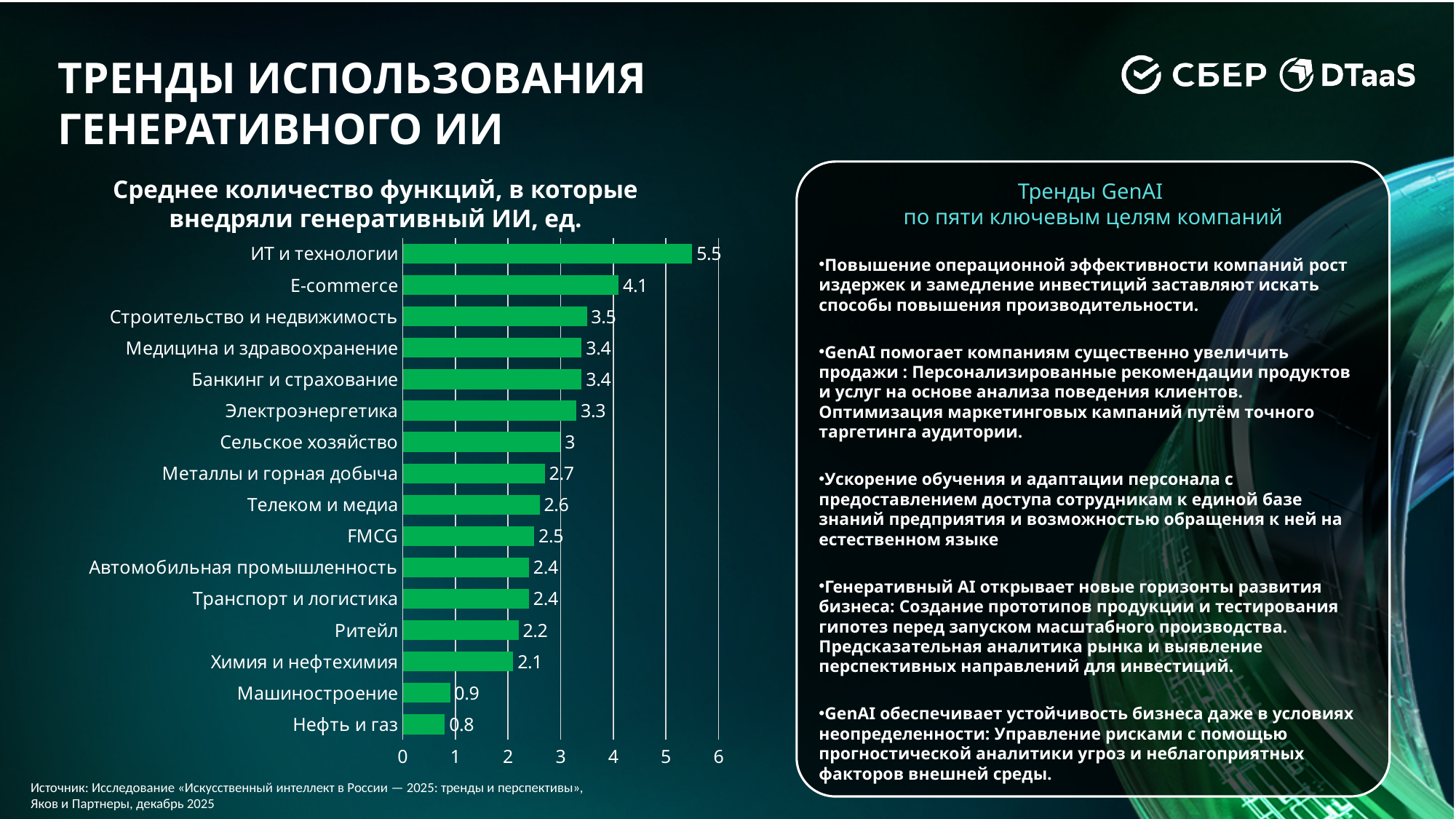
What is the value for Телеком и медиа? 2.6 Which category has the lowest value? Нефть и газ What is the value for ИТ и технологии? 5.5 Is the value for Сельское хозяйство greater or less than 2? greater How many categories are shown in the chart? 16 Which category has the highest value? ИТ и технологии Which is larger, the value for E-commerce or the value for Строительство и недвижимость? E-commerce What is the value for E-commerce? 4.1 What is the value for Нефть и газ? 0.8 What type of chart is shown on the slide? Bar chart What is the title of the chart? Среднее количество функций, в которые внедряли генеративный ИИ, ед. What is the difference between the values for ИТ и технологии and E-commerce? 1.4